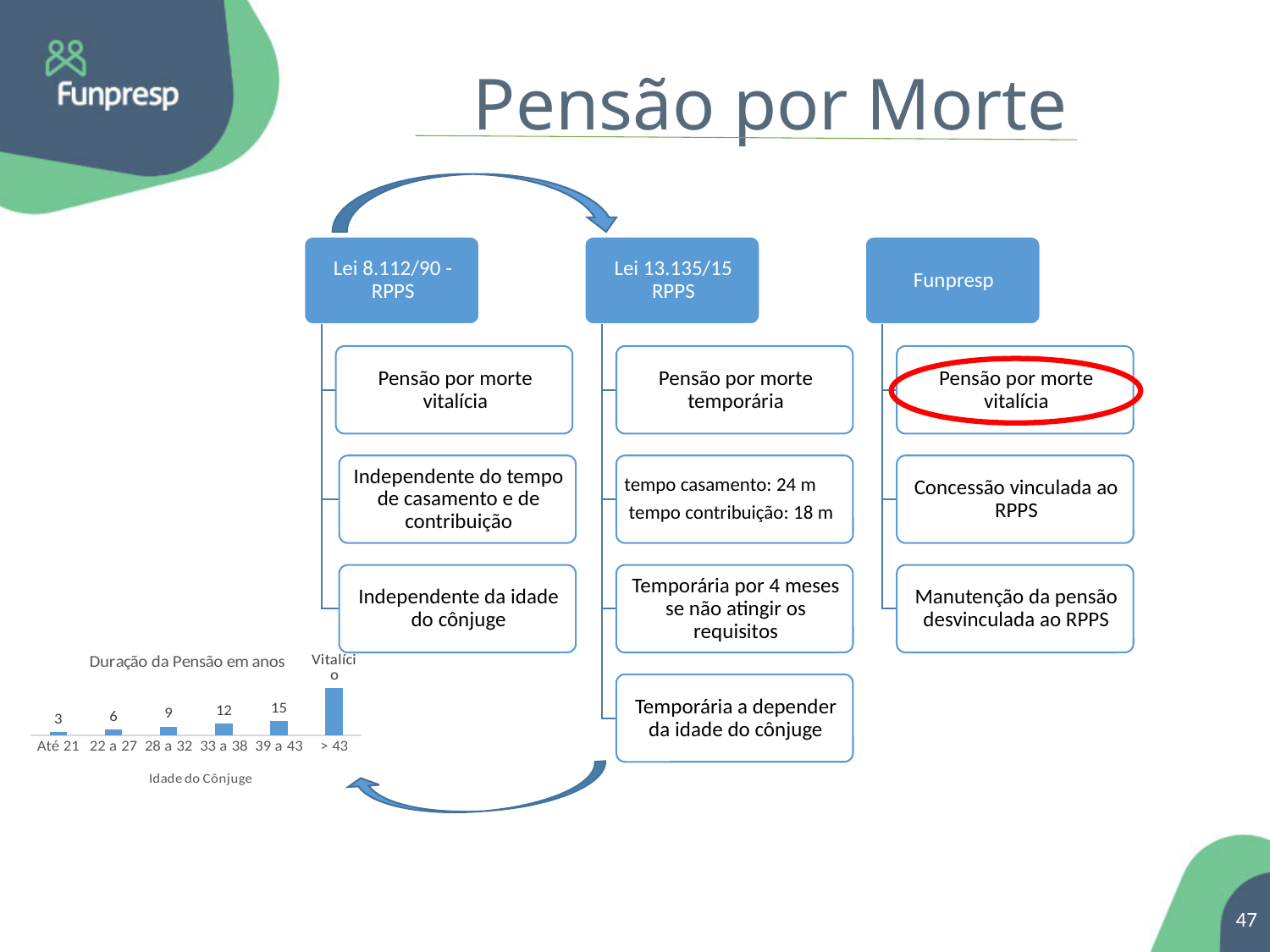
What is the title of the chart on the slide? Duração da Pensão em anos What is the difference between the values for '39 a 43' and 'Até 21'? 12 What is the value for the category 'Até 21'? 3 What is the value for the category '22 a 27'? 6 Do the values rise or fall from 'Até 21' to '39 a 43' along the x axis? rise How many categories are shown on the x axis of the chart? 6 What is the value for the category '39 a 43'? 15 What label is shown on the bar for the category '> 43'? Vitalício What is the value for the category '28 a 32'? 9 What is the value for the category '33 a 38'? 12 What type of chart is shown on the slide? bar chart Which is larger, the value for '33 a 38' or the value for '22 a 27'? 33 a 38